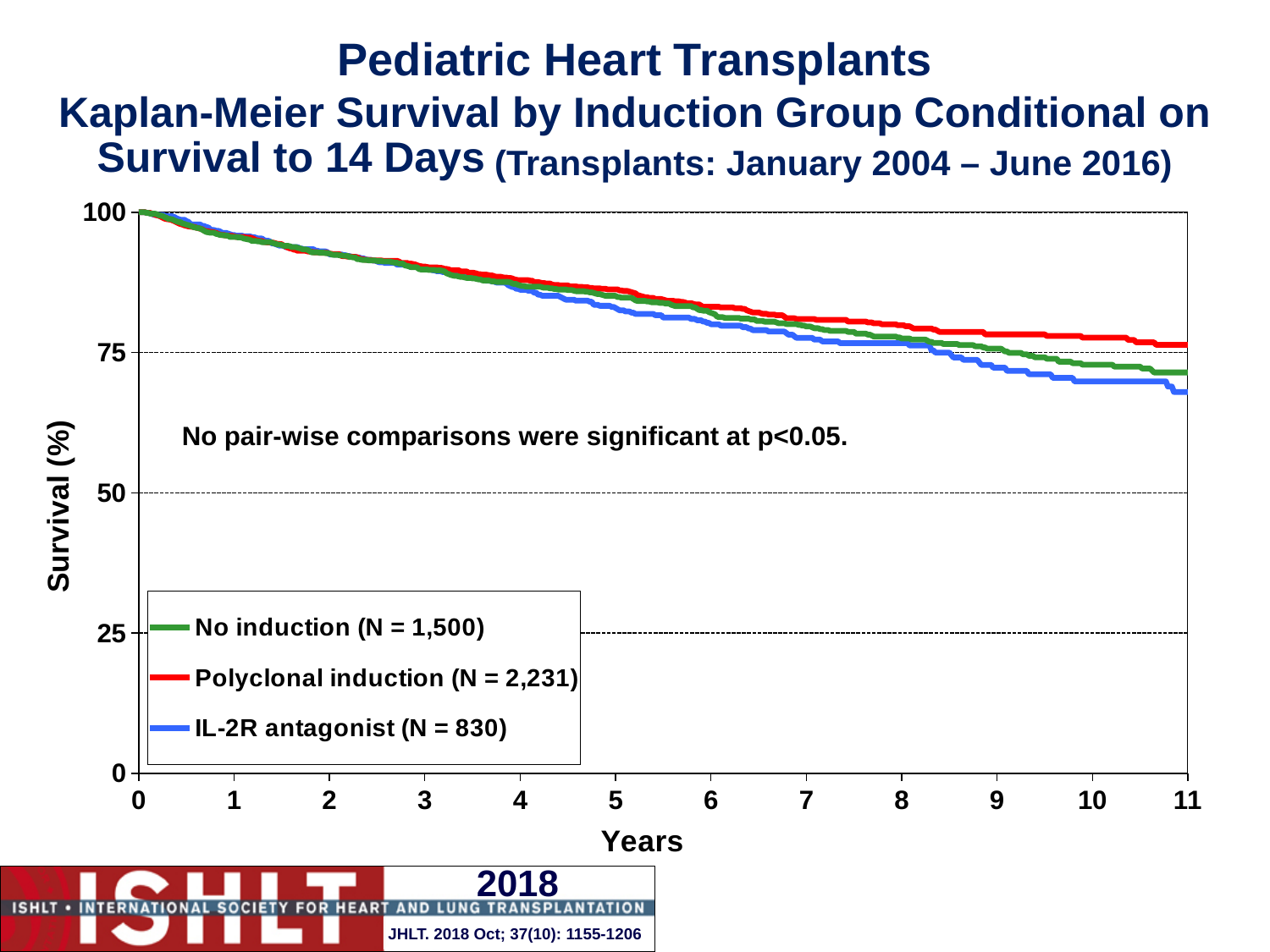
Is the survival for IL-2R antagonist at 5 years greater or less than 75? greater What kind of chart is shown on the slide? line chart Is the survival for Polyclonal induction at 11 years greater or less than 75? greater What is the N for the Polyclonal induction group shown in the legend? 2,231 Is the survival for IL-2R antagonist at 11 years greater or less than 75? less How many series does the legend list? 3 Which induction group has the highest survival at 11 years? Polyclonal induction Which induction group has the lowest survival at 11 years? IL-2R antagonist What is the label of the y axis? Survival (%) Do the survival curves rise or fall as years increase? fall At 11 years, which is larger: survival for Polyclonal induction or for IL-2R antagonist? Polyclonal induction